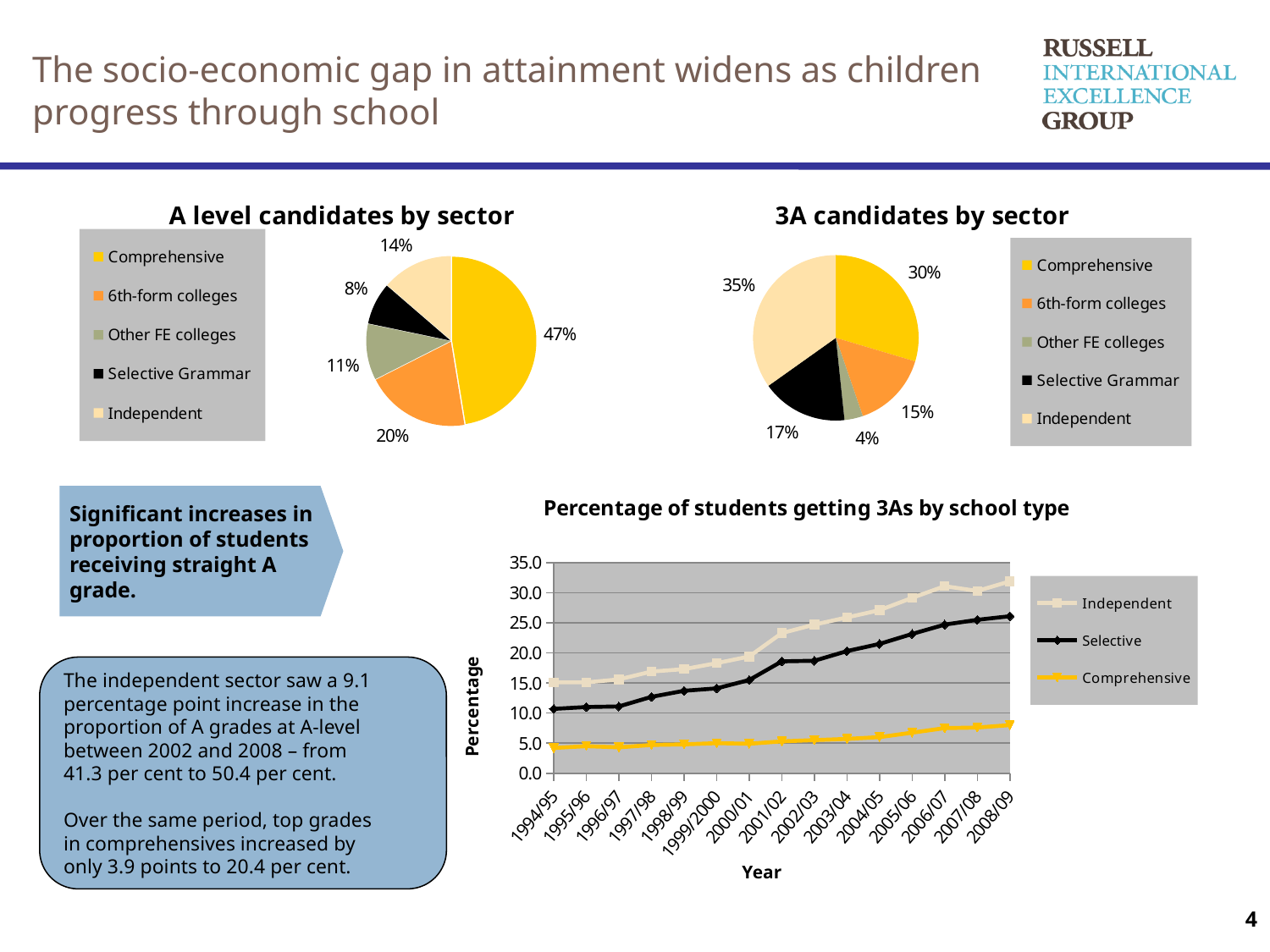
In the '3A candidates by sector' pie chart, which is larger: Selective Grammar or Other FE colleges? Selective Grammar In the 'A level candidates by sector' pie chart, which sector has the smallest share? Selective Grammar In 'Percentage of students getting 3As by school type', is the Independent value for 2008/09 greater or less than 30.0? greater In the '3A candidates by sector' pie chart, what share is Independent? 35% How many sectors are shown in the 'A level candidates by sector' pie chart? 5 How many series does the legend of 'Percentage of students getting 3As by school type' list? 3 In 'Percentage of students getting 3As by school type', does the Selective series rise or fall from 1994/95 to 2008/09? Rise In the '3A candidates by sector' pie chart, which sector has the largest share? Independent In the 'A level candidates by sector' pie chart, what share is Selective Grammar? 8% In the '3A candidates by sector' pie chart, what is the difference between the Comprehensive and 6th-form colleges shares? 15% What kind of chart is 'Percentage of students getting 3As by school type'? Line chart In the 'A level candidates by sector' pie chart, what share is Comprehensive? 47%